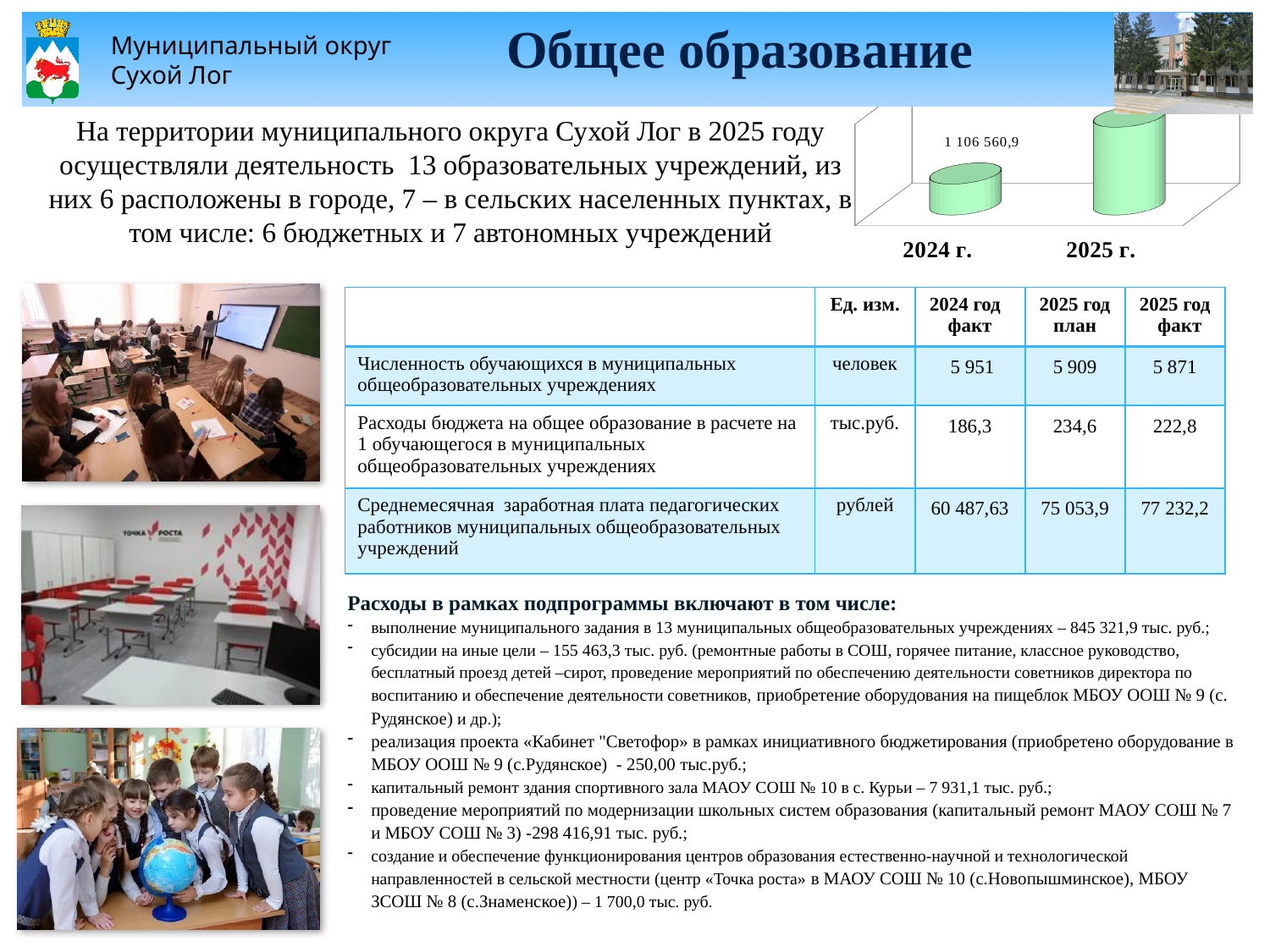
Which category has the lowest value in the chart at the top right of the slide? 2024 г. What colour are the bars in the chart at the top right of the slide? green What data label is printed above the 2024 г. bar in the chart at the top right of the slide? 1 106 560,9 In the chart at the top right of the slide, do the values rise or fall from 2024 г. to 2025 г.? rise What are the category labels shown under the bars in the chart at the top right of the slide? 2024 г. and 2025 г. Which category has the highest value in the chart at the top right of the slide? 2025 г. In the chart at the top right of the slide, which is larger, the value for 2024 г. or for 2025 г.? 2025 г. What kind of chart is shown at the top right of the slide? bar chart How many categories are plotted in the chart at the top right of the slide? 2